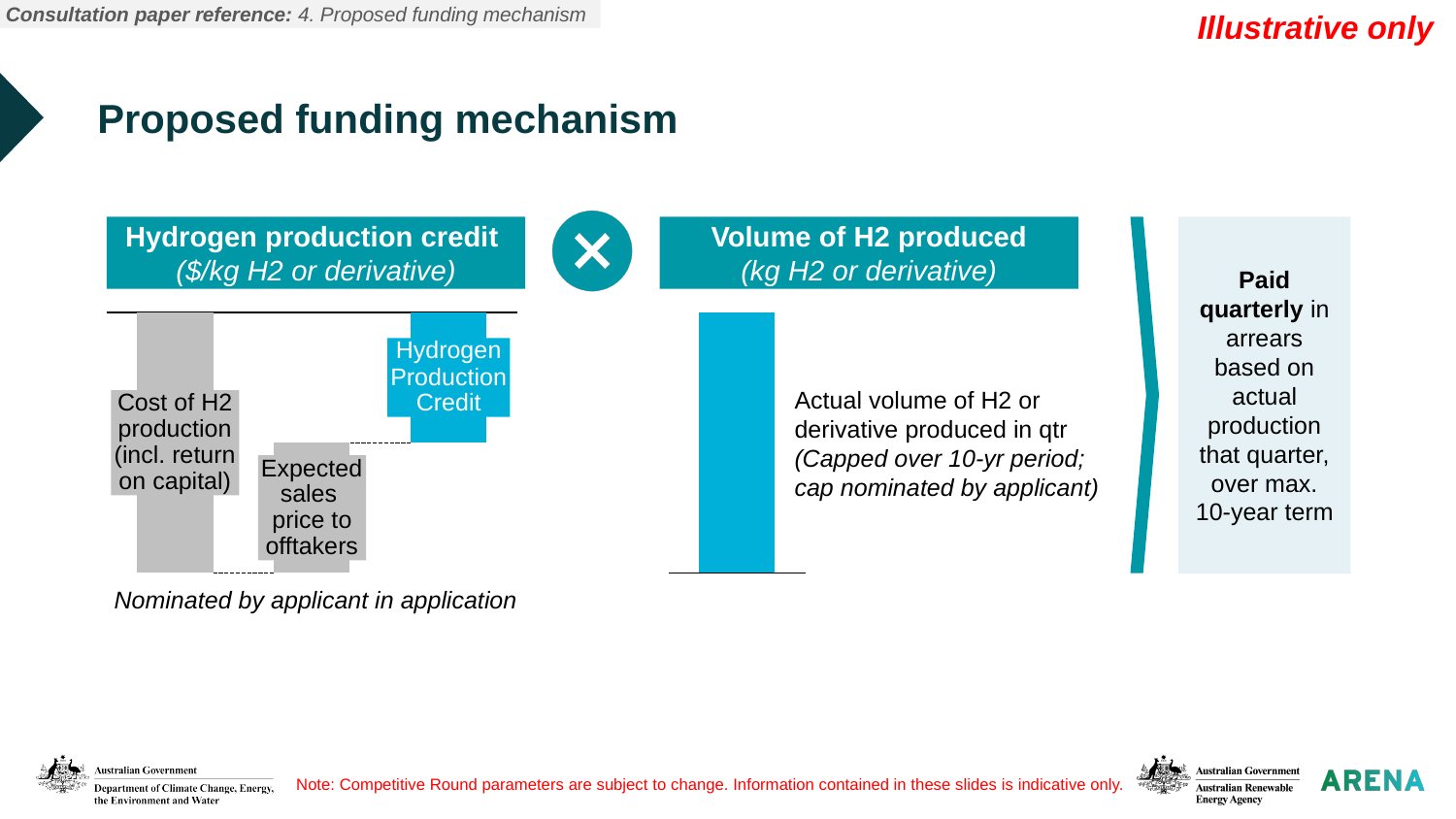
What kind of chart is used in the left diagram under 'Hydrogen production credit'? Bar chart In the left diagram under 'Hydrogen production credit', how many bars are shown? 3 In the left diagram, what colour is the 'Hydrogen Production Credit' bar? Blue In the right diagram under 'Volume of H2 produced', how many bars are shown? 1 In the left diagram under 'Hydrogen production credit', which bar is the tallest? Cost of H2 production (incl. return on capital) In the left diagram under 'Hydrogen production credit', which is taller: the 'Cost of H2 production' bar or the 'Expected sales price to offtakers' bar? Cost of H2 production What unit is given in the header of the left diagram, 'Hydrogen production credit'? $/kg H2 or derivative